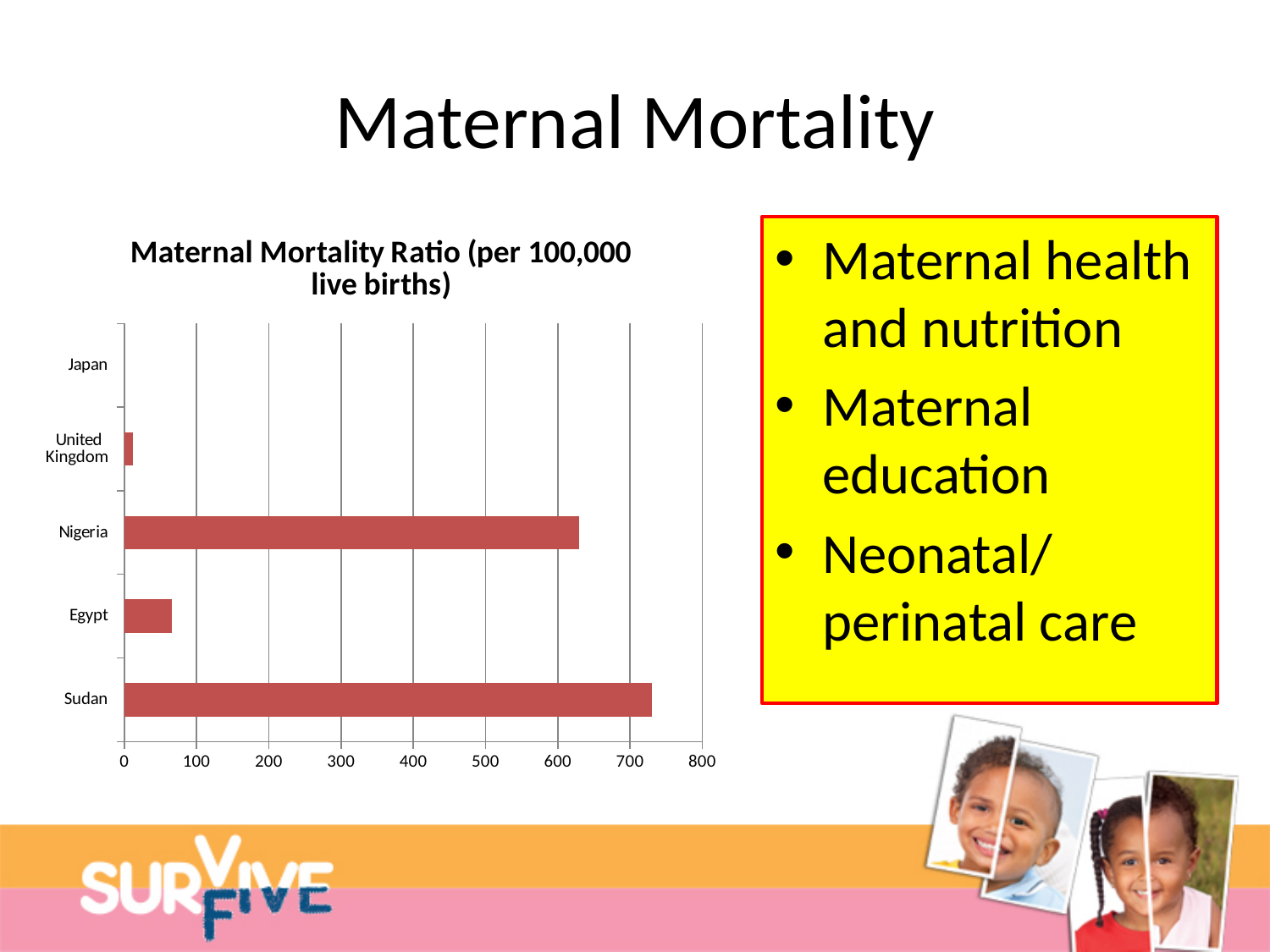
What kind of chart is shown on the slide? bar chart Which has a higher maternal mortality ratio, Egypt or the United Kingdom? Egypt Is the value for the United Kingdom greater or less than 100? less Which has a higher maternal mortality ratio, Nigeria or Egypt? Nigeria What is the title of the chart? Maternal Mortality Ratio (per 100,000 live births) What is the highest value shown on the chart's horizontal axis? 800 Is the value for Egypt greater or less than 100? less Is the value for Nigeria greater or less than 600? greater Which country has the highest maternal mortality ratio in the chart? Sudan How many countries are shown in the Maternal Mortality Ratio chart? 5